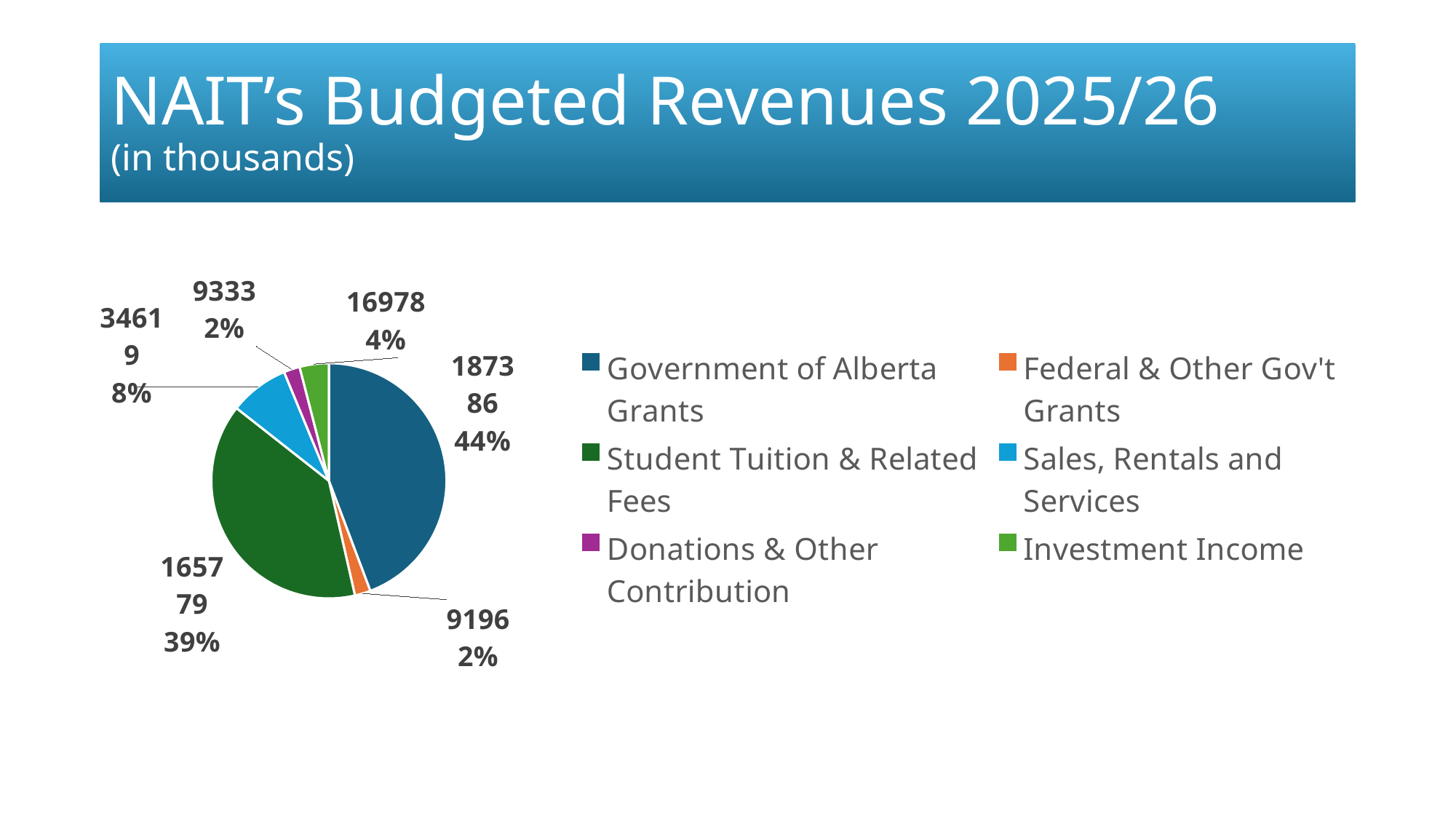
How many percentage points larger is the Government of Alberta Grants share than the Student Tuition & Related Fees share? 5% Which is larger, Sales, Rentals and Services or Investment Income? Sales, Rentals and Services What is the value (in thousands) for Investment Income? 16978 What is the value (in thousands) for Donations & Other Contribution? 9333 What kind of chart is shown on the slide? pie chart Which revenue source is the largest slice of the pie? Government of Alberta Grants What share of NAIT's budgeted revenues comes from Sales, Rentals and Services? 8% What share of NAIT's budgeted revenues comes from Student Tuition & Related Fees? 39% What is the value (in thousands) for Federal & Other Gov't Grants? 9196 What share of NAIT's budgeted revenues comes from Government of Alberta Grants? 44% How many revenue categories does the legend list? 6